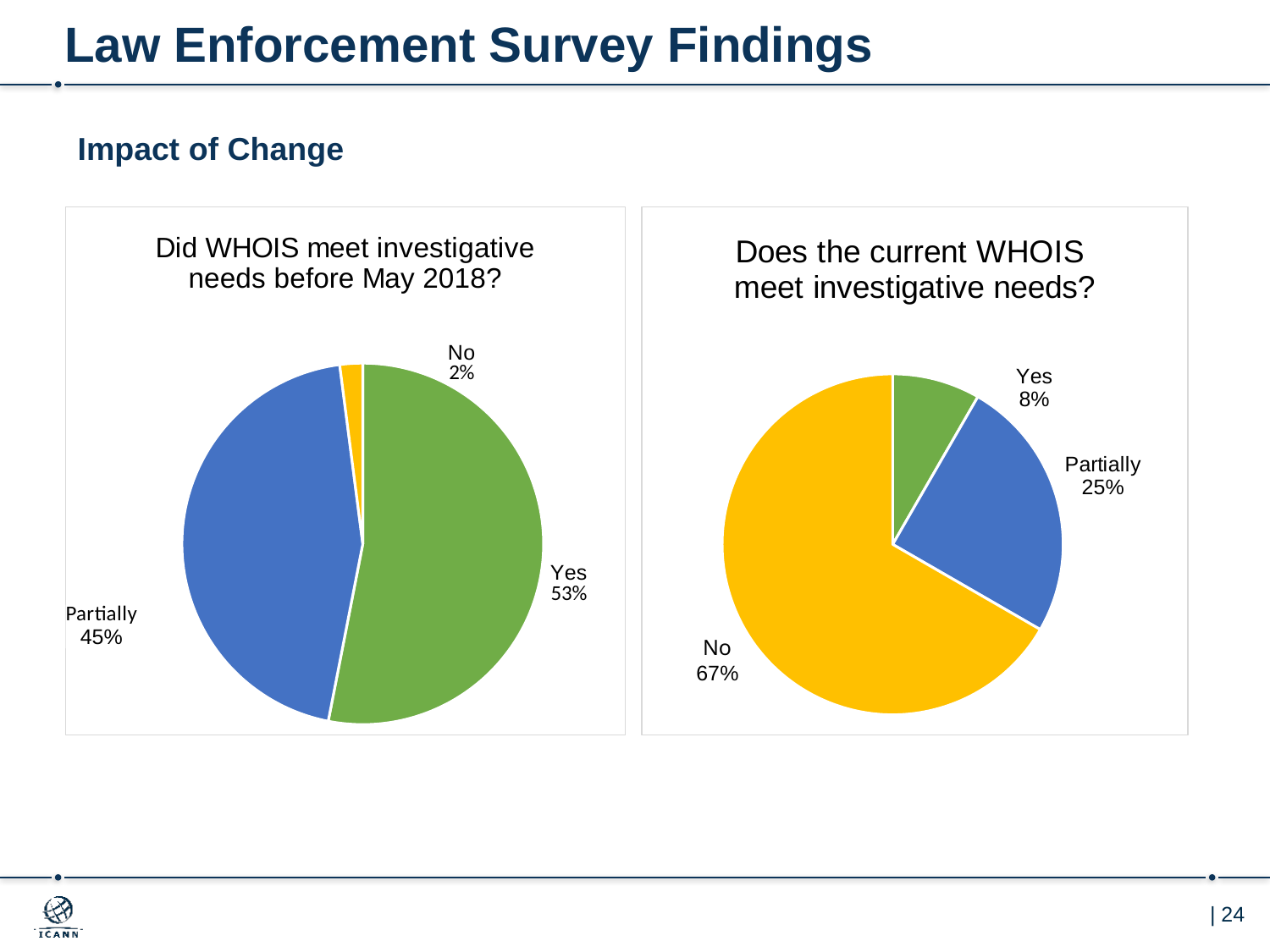
How many slices does the chart titled "Does the current WHOIS meet investigative needs?" have? 3 In the chart titled "Did WHOIS meet investigative needs before May 2018?", which response has the smallest share? No In the chart titled "Does the current WHOIS meet investigative needs?", what percentage answered Partially? 25% In the chart titled "Does the current WHOIS meet investigative needs?", which is larger, the Yes share or the Partially share? Partially In the chart titled "Did WHOIS meet investigative needs before May 2018?", what percentage answered Yes? 53% In the chart titled "Does the current WHOIS meet investigative needs?", which response has the largest share? No In the chart titled "Does the current WHOIS meet investigative needs?", what percentage answered No? 67% In the chart titled "Did WHOIS meet investigative needs before May 2018?", what is the difference between the Yes and Partially shares? 8% In the chart titled "Does the current WHOIS meet investigative needs?", which response has the smallest share? Yes What type of chart is used on the left side of the slide? Pie chart In the chart titled "Does the current WHOIS meet investigative needs?", what is the difference between the No and Partially shares? 42% In the chart titled "Did WHOIS meet investigative needs before May 2018?", what percentage answered Partially? 45%